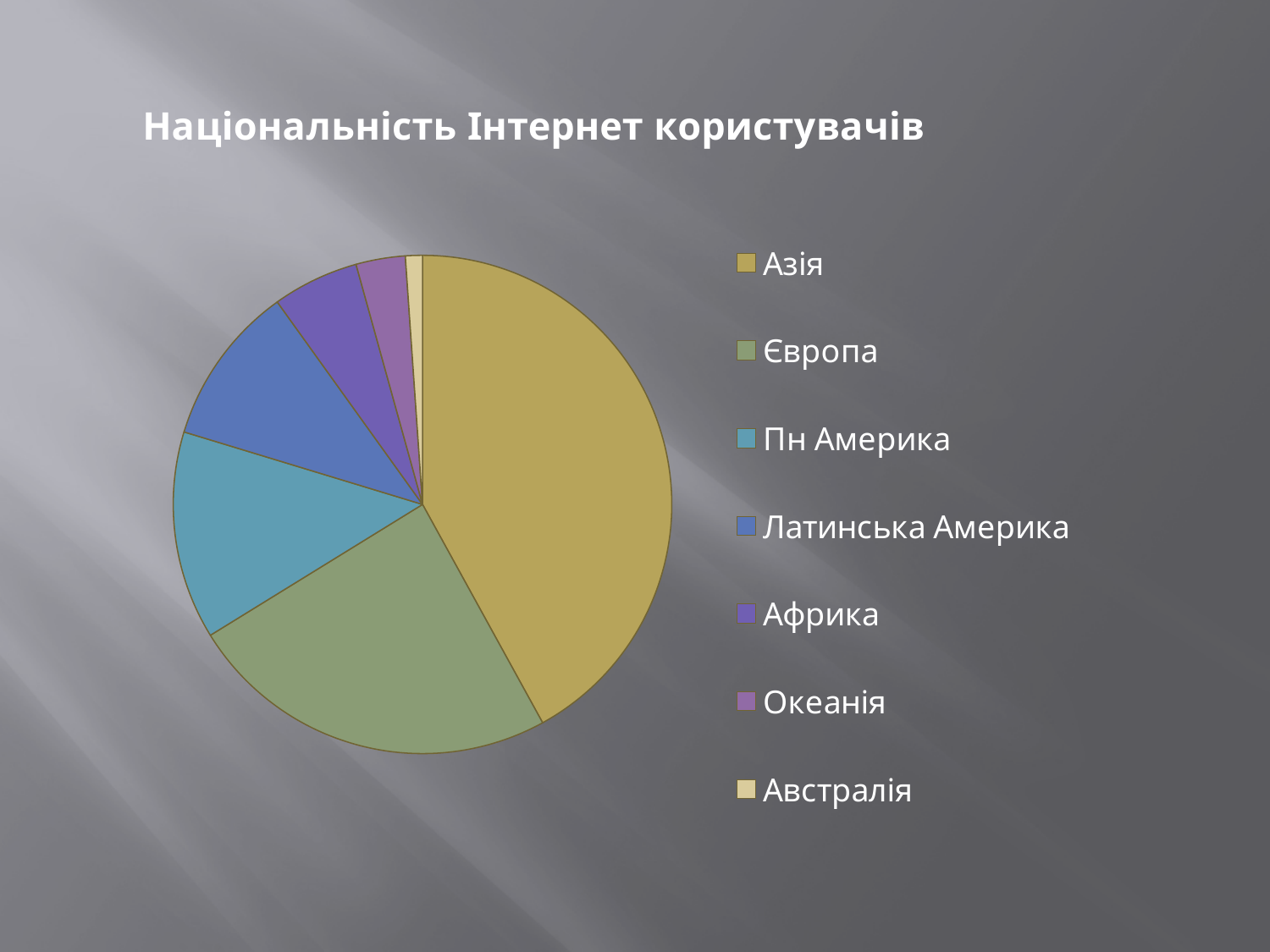
Which slice is larger, Азія or Європа? Азія Which slice is larger, Європа or Пн Америка? Європа Which category has the second-largest slice of the pie? Європа Which slice is larger, Латинська Америка or Африка? Латинська Америка Which category is listed first in the legend? Азія Which category has the smallest slice of the pie? Австралія Which category has the largest slice of the pie? Азія What kind of chart is shown on the slide? Pie chart How many slices does the pie chart have? 7 What is the title of the chart? Національність Інтернет користувачів